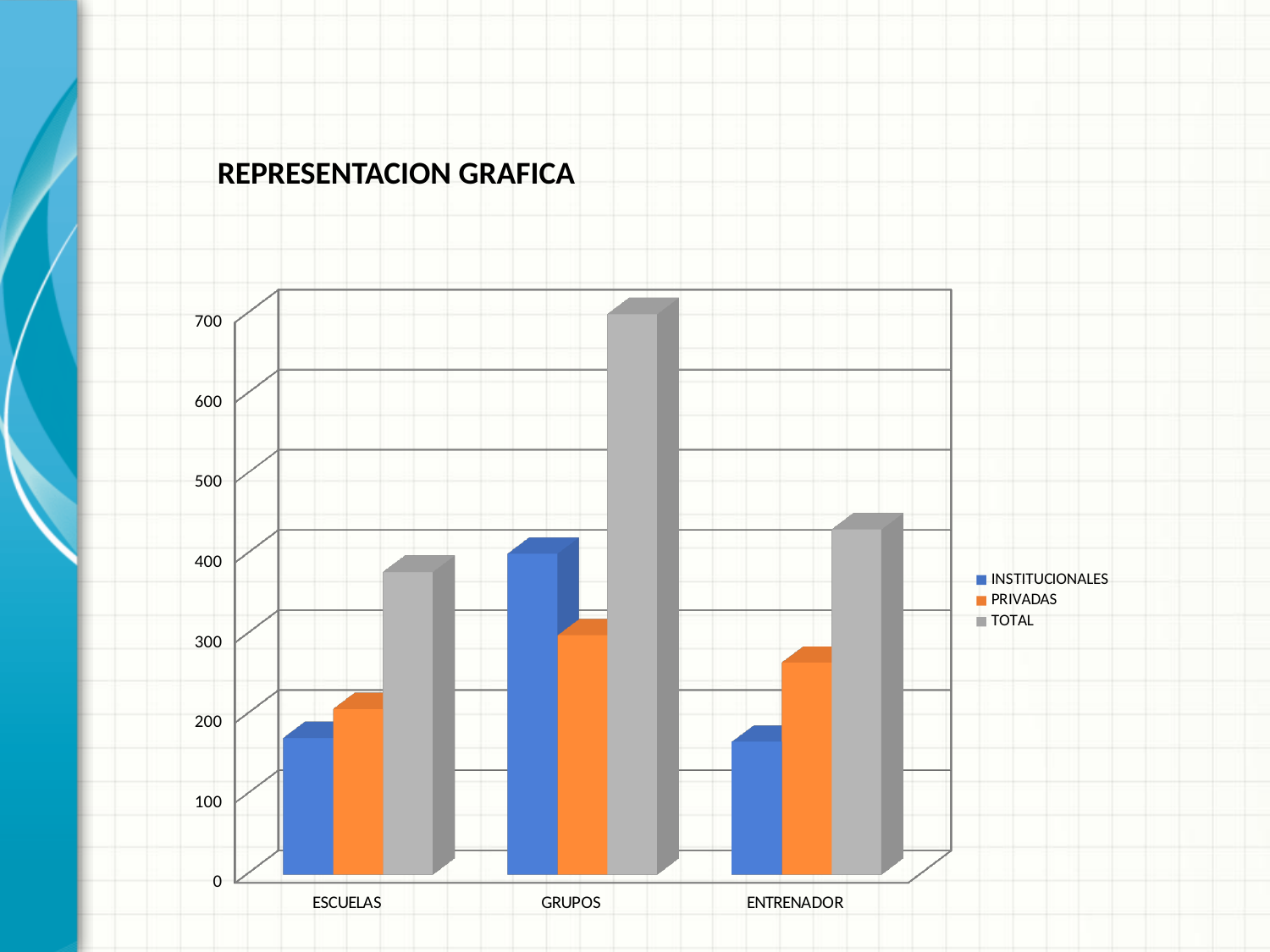
Is the TOTAL value for GRUPOS greater or less than 600? greater Which colour represents the TOTAL series in the legend? gray How many categories are shown on the x axis? 3 What is the title of the chart? REPRESENTACION GRAFICA How many series does the legend list? 3 For GRUPOS, which is larger: INSTITUCIONALES or PRIVADAS? INSTITUCIONALES Is the INSTITUCIONALES value for GRUPOS greater or less than 300? greater Is the INSTITUCIONALES value for ESCUELAS greater or less than 300? less For ENTRENADOR, which is larger: INSTITUCIONALES or PRIVADAS? PRIVADAS Which category has the highest TOTAL value? GRUPOS Which category has the lowest TOTAL value? ESCUELAS What type of chart is shown on the slide? bar chart